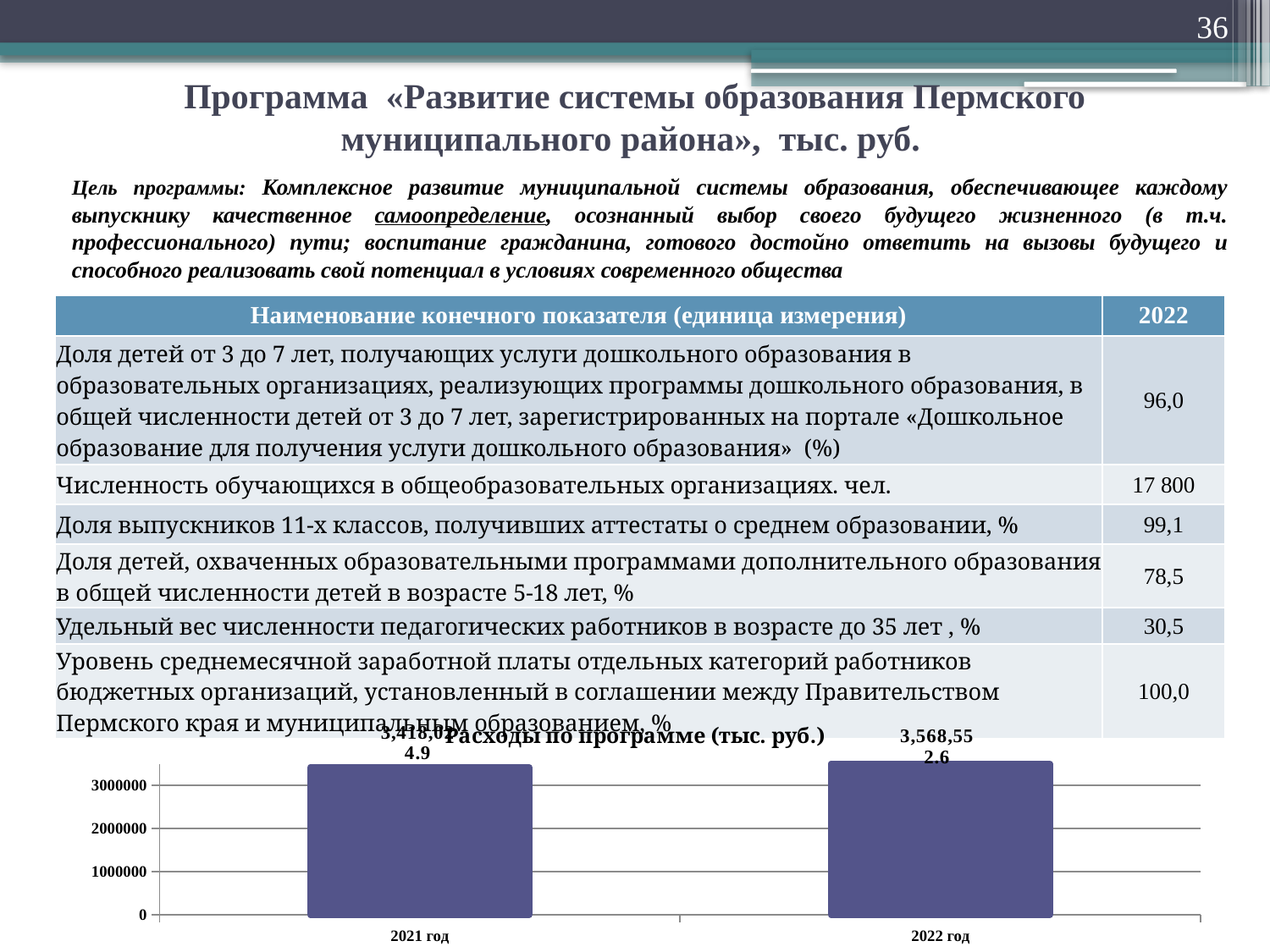
What kind of chart is shown at the bottom of the slide? bar chart What is the title of the chart at the bottom of the slide? Расходы по программе (тыс. руб.) In the chart "Расходы по программе (тыс. руб.)", which category has the lowest value? 2021 год In the chart "Расходы по программе (тыс. руб.)", what is the value for 2022 год? 3,568,552.6 In the chart "Расходы по программе (тыс. руб.)", do the values rise or fall from 2021 год to 2022 год? rise What is the highest tick value shown on the vertical axis of the chart "Расходы по программе (тыс. руб.)"? 3000000 In the chart "Расходы по программе (тыс. руб.)", is the value for 2022 год greater or less than 2000000? greater In the chart "Расходы по программе (тыс. руб.)", is the value for 2021 год greater or less than 3000000? greater How many categories (years) are plotted in the chart "Расходы по программе (тыс. руб.)"? 2 In the chart "Расходы по программе (тыс. руб.)", which year has the higher value, 2021 год or 2022 год? 2022 год In the chart "Расходы по программе (тыс. руб.)", which category has the highest value? 2022 год